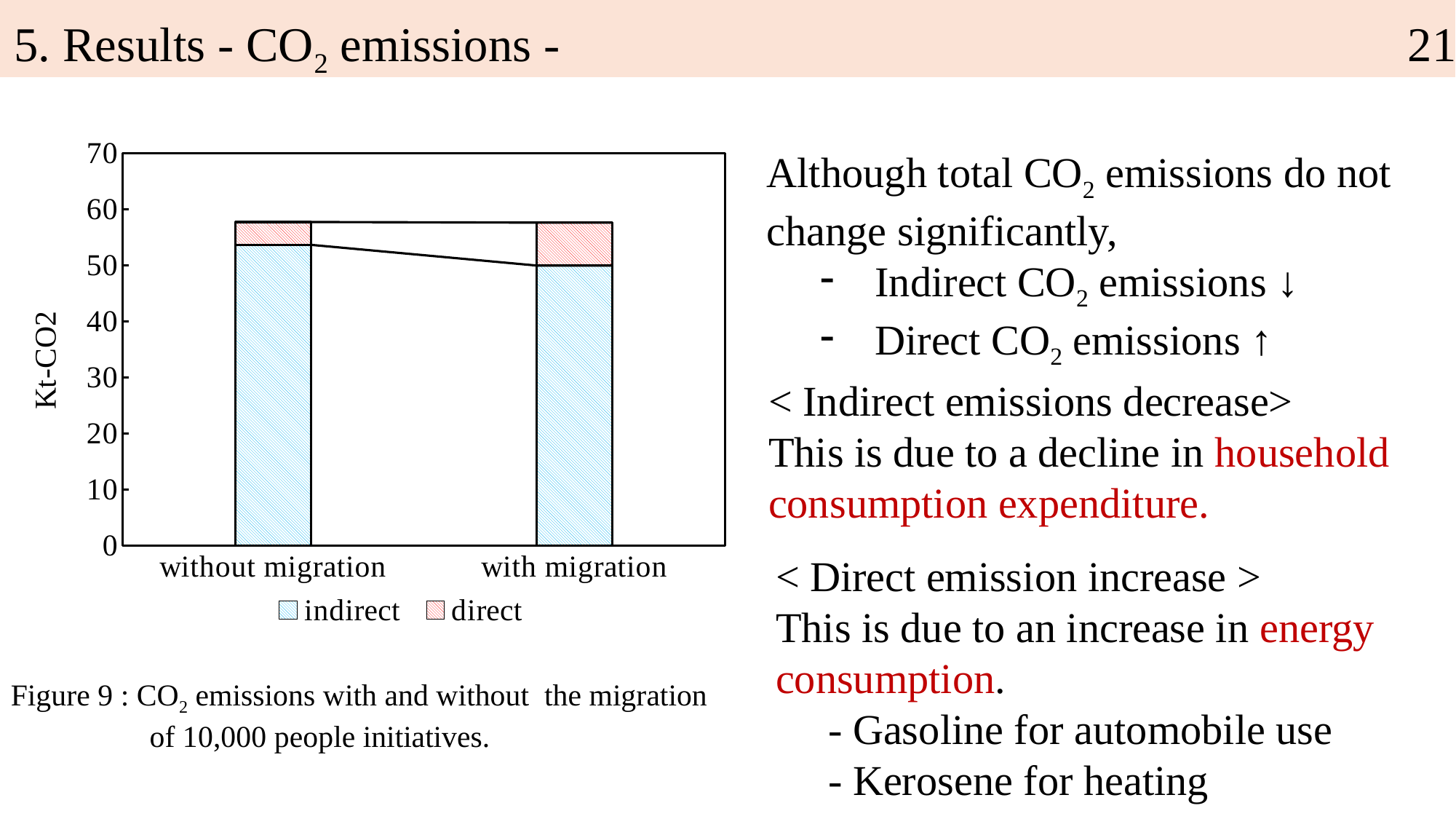
Is the indirect value for 'without migration' greater or less than 50? greater How many categories are shown on the x axis of the chart? 2 What kind of chart is shown on the slide? stacked bar chart What is the label on the y axis of the chart? Kt-CO2 Is the total stacked bar for 'with migration' greater or less than 60? less Is the direct value for 'with migration' greater or less than 20? less How many series does the chart's legend list? 2 Which series are listed in the chart's legend? indirect, direct Which category has the larger direct value, 'without migration' or 'with migration'? with migration Does the indirect value rise or fall from 'without migration' to 'with migration'? fall Which category has the larger indirect value, 'without migration' or 'with migration'? without migration